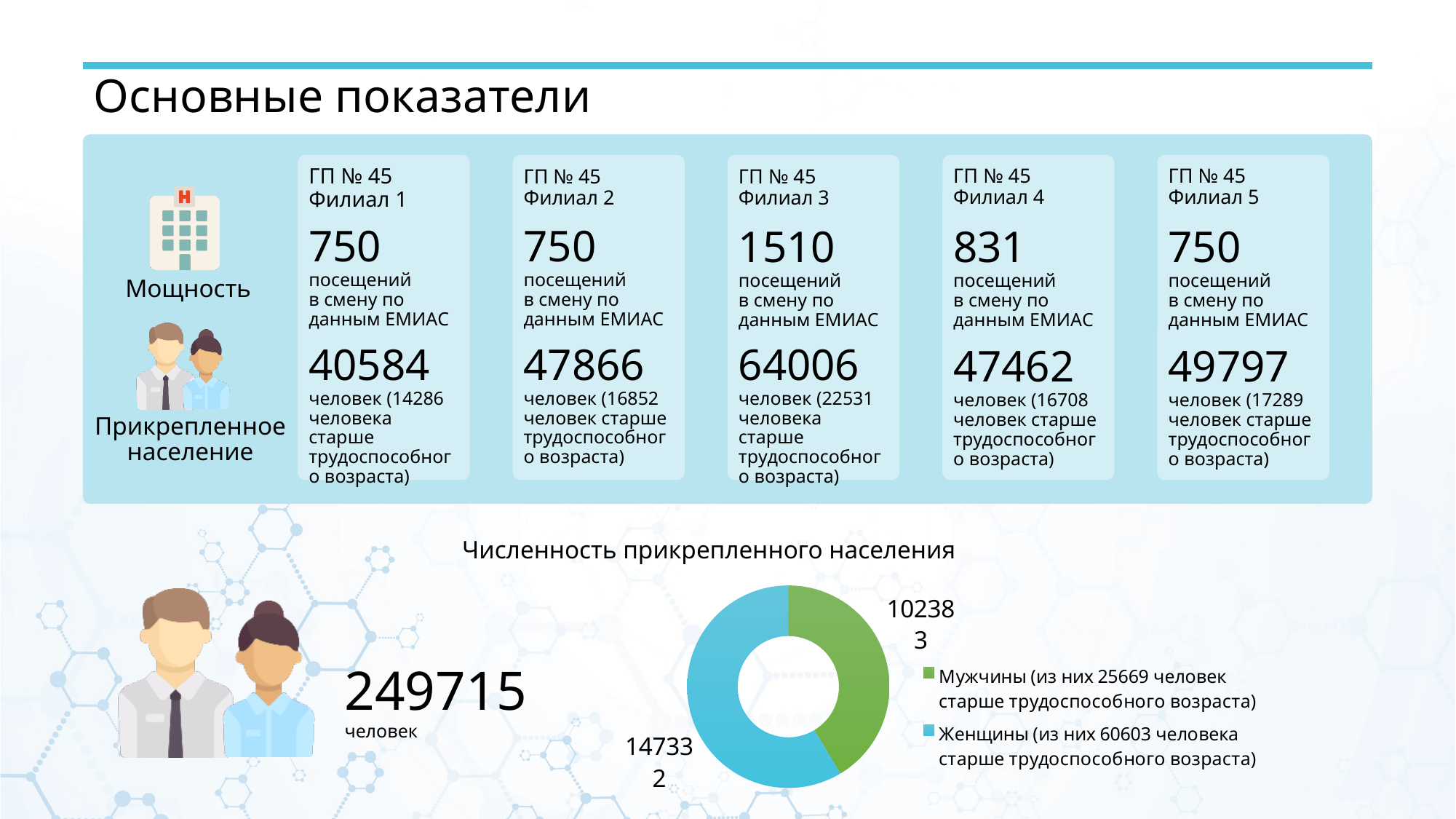
Which is larger in the donut chart, Мужчины or Женщины? Женщины How many entries does the legend of the donut chart list? 2 What is the value for Женщины in the donut chart? 147332 What is the difference between the values for Женщины and Мужчины in the donut chart? 44949 Which category has the smallest slice in the donut chart? Мужчины What is the total of the two slices in the donut chart? 249715 What is the title of the donut chart? Численность прикрепленного населения Which category has the largest slice in the donut chart? Женщины What type of chart is shown at the bottom of the slide? Pie (donut) chart What is the value for Мужчины in the donut chart? 102383 What share of the donut chart does Женщины represent? 59% How many slices does the donut chart have? 2